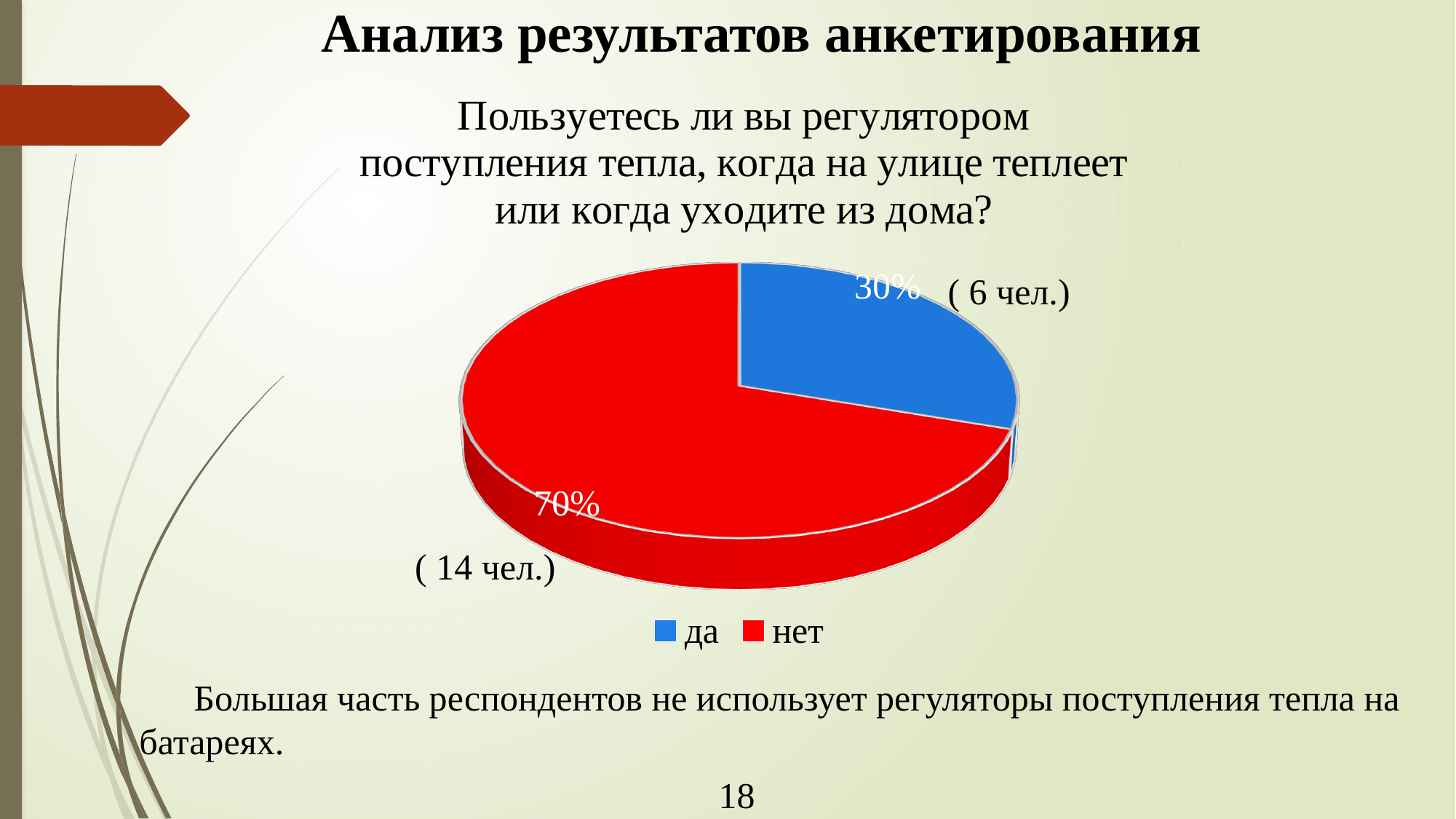
Which is larger, the share for "да" or the share for "нет"? нет Which answer has the largest share of the pie? нет What is the difference in percentage points between the "нет" and "да" slices? 40 How many people answered "нет"? 14 чел. What kind of chart is shown on the slide? pie chart What percentage of respondents answered "да"? 30% How many slices does the pie chart have? 2 How many entries does the legend list? 2 How many people answered "да"? 6 чел. What colour is the "нет" slice? red What percentage of respondents answered "нет"? 70% Which answer has the smallest share of the pie? да